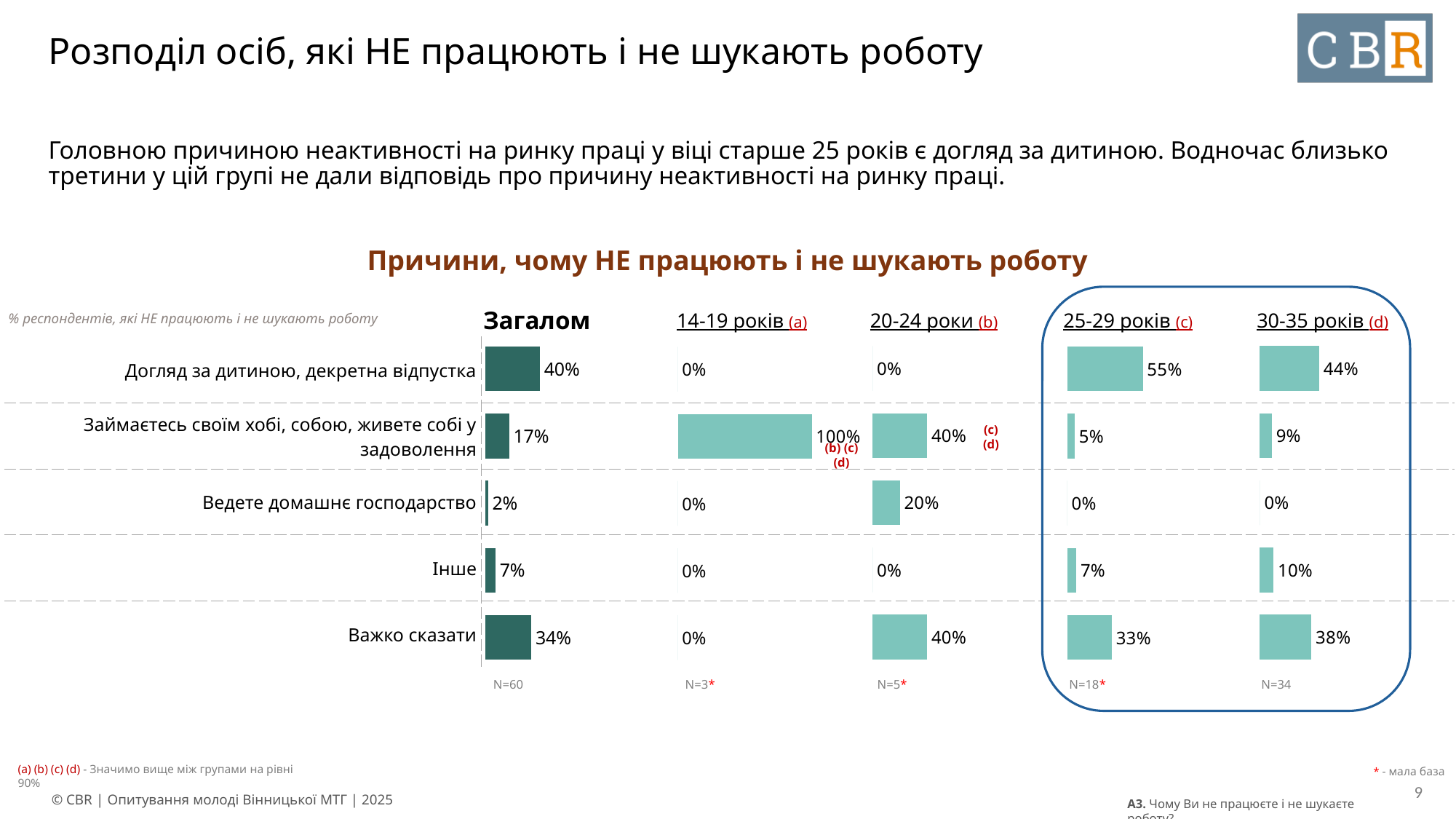
What is the value for "Догляд за дитиною, декретна відпустка" in the "Загалом" column? 40% What is the difference between the "Догляд за дитиною, декретна відпустка" values for "25-29 років" and "30-35 років"? 11 percentage points What type of chart is shown on the slide? Bar chart What is the value for "Ведете домашнє господарство" in the "20-24 роки" column? 20% Which category has the lowest value in the "Загалом" column? Ведете домашнє господарство How many age-group columns (excluding "Загалом") does the chart show? 4 What is the value for "Займаєтесь своїм хобі, собою, живете собі у задоволення" in the "14-19 років" column? 100% What is the sample size (N) shown for the "Загалом" column? N=60 How many reason categories are listed in the chart? 5 What is the value for "Важко сказати" in the "30-35 років" column? 38% Which category has the highest value in the "25-29 років" column? Догляд за дитиною, декретна відпустка Which is larger: "Важко сказати" for "Загалом" or "Важко сказати" for "20-24 роки"? 20-24 роки